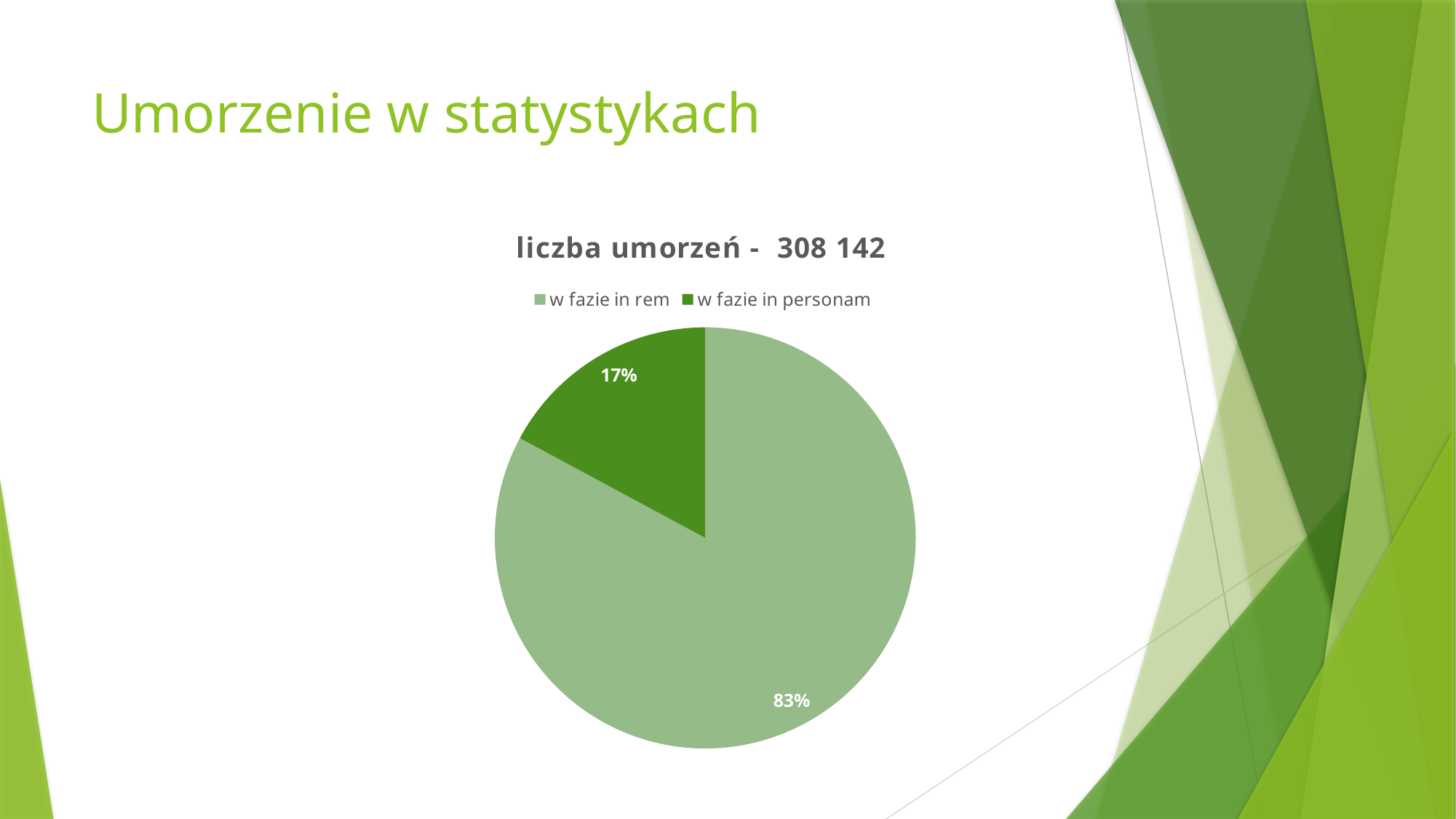
What is the difference in percentage points between the "w fazie in rem" slice and the "w fazie in personam" slice? 66 percentage points Which slice is the smallest? w fazie in personam What total number of umorzenia is stated in the chart title? 308 142 What share of the pie does "w fazie in personam" take? 17% How many slices does the pie chart have? 2 Which is larger, the slice for "w fazie in rem" or the slice for "w fazie in personam"? w fazie in rem What is the title of the chart? liczba umorzeń - 308 142 How many entries does the legend list? 2 What kind of chart is shown on the slide? pie chart Is the share for "w fazie in personam" greater or less than 50%? less Which slice is the largest? w fazie in rem What share of the pie does "w fazie in rem" take? 83%